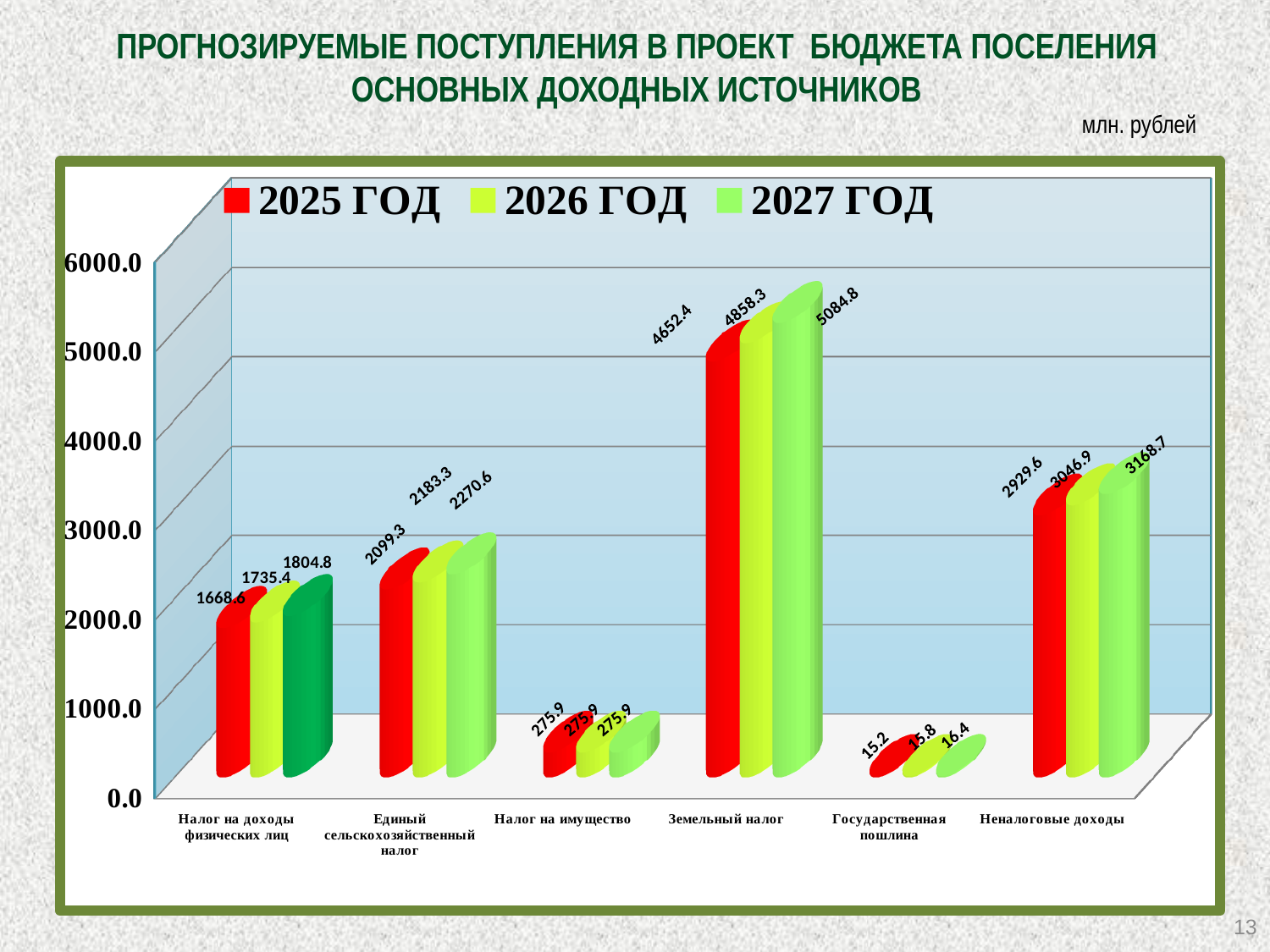
What is the difference between the 2027 ГОД and 2025 ГОД values for Земельный налог? 432.4 What kind of chart is shown on the slide? bar chart Which category has the lowest value in the 2026 ГОД series? Государственная пошлина What is the value for Земельный налог in the 2027 ГОД series? 5084.8 What is the value for Неналоговые доходы in the 2026 ГОД series? 3046.9 Which is larger: the 2027 ГОД value for Единый сельскохозяйственный налог or the 2025 ГОД value for Неналоговые доходы? 2025 ГОД value for Неналоговые доходы How many series does the legend list? 3 How many categories are shown on the x axis? 6 Is the 2026 ГОД value for Единый сельскохозяйственный налог greater or less than 2000.0? greater What is the value for Налог на доходы физических лиц in the 2025 ГОД series? 1668.6 Which category has the highest value in the 2025 ГОД series? Земельный налог What is the value for Государственная пошлина in the 2027 ГОД series? 16.4